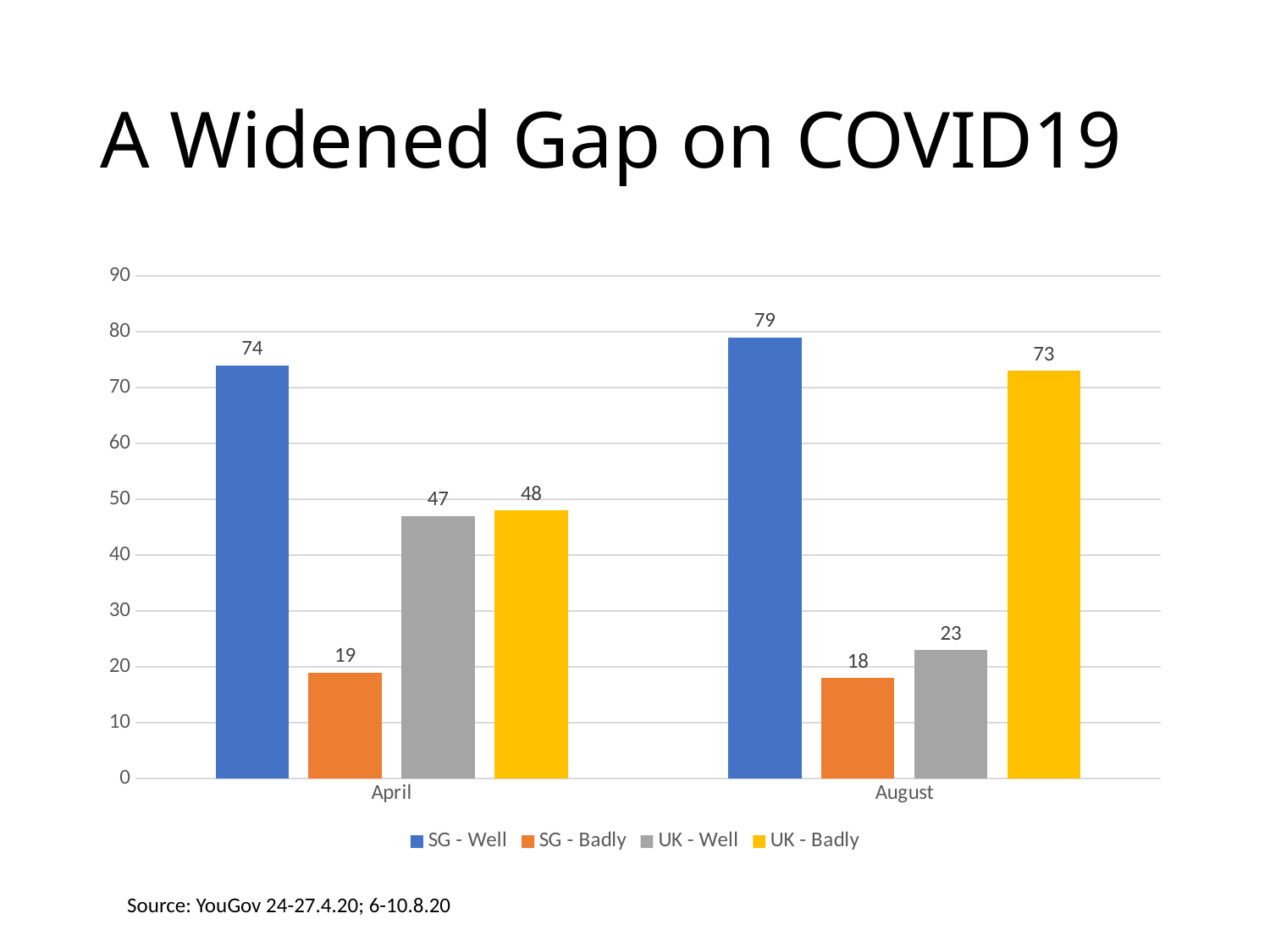
Which series has the lowest value in April? SG - Badly How many series does the legend list? 4 Does the value for UK - Well rise or fall from April to August? Fall What kind of chart is shown on the slide? Bar chart How many categories are shown on the x axis? 2 What is the value for SG - Well in April? 74 What is the value for UK - Well in August? 23 Which is larger: SG - Well in April or SG - Well in August? SG - Well in August What is the difference between SG - Well and UK - Well in August? 56 What is the difference between UK - Badly in August and UK - Badly in April? 25 What is the value for UK - Badly in August? 73 Which series has the highest value in August? SG - Well